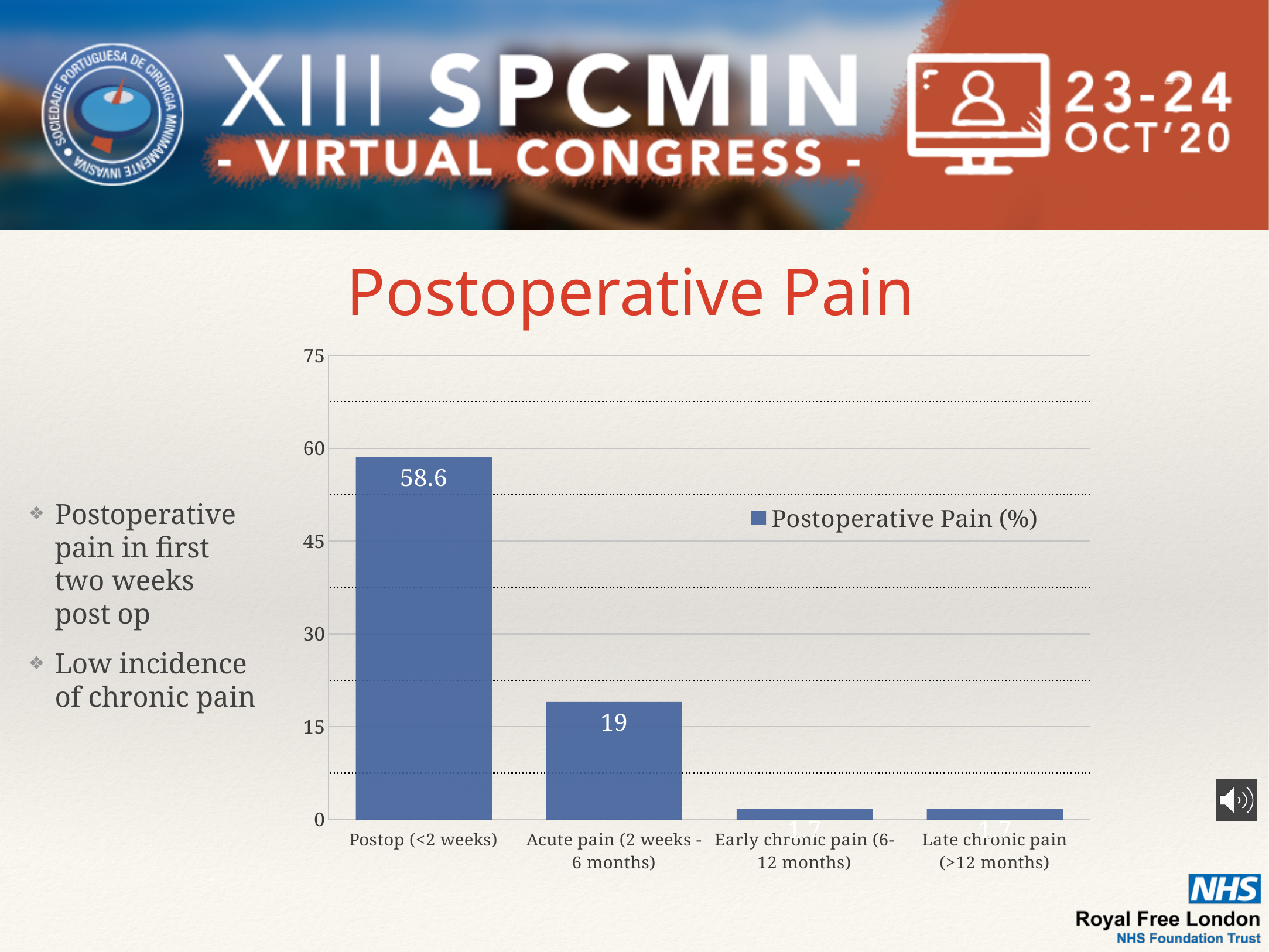
Is the value for Postop (<2 weeks) greater or less than 45? greater Which category has the highest value? Postop (<2 weeks) Which is larger, the value for Acute pain (2 weeks - 6 months) or the value for Early chronic pain (6-12 months)? Acute pain (2 weeks - 6 months) What type of chart is shown on the slide? bar chart Is the value for Late chronic pain (>12 months) greater or less than 15? less How many series does the legend list? 1 How many categories are shown on the x axis? 4 What is the value for Acute pain (2 weeks - 6 months)? 19 What is the value for Postop (<2 weeks)? 58.6 What is the difference between the values for Postop (<2 weeks) and Acute pain (2 weeks - 6 months)? 39.6 Is the value for Early chronic pain (6-12 months) greater or less than 15? less What is the legend entry for the series? Postoperative Pain (%)